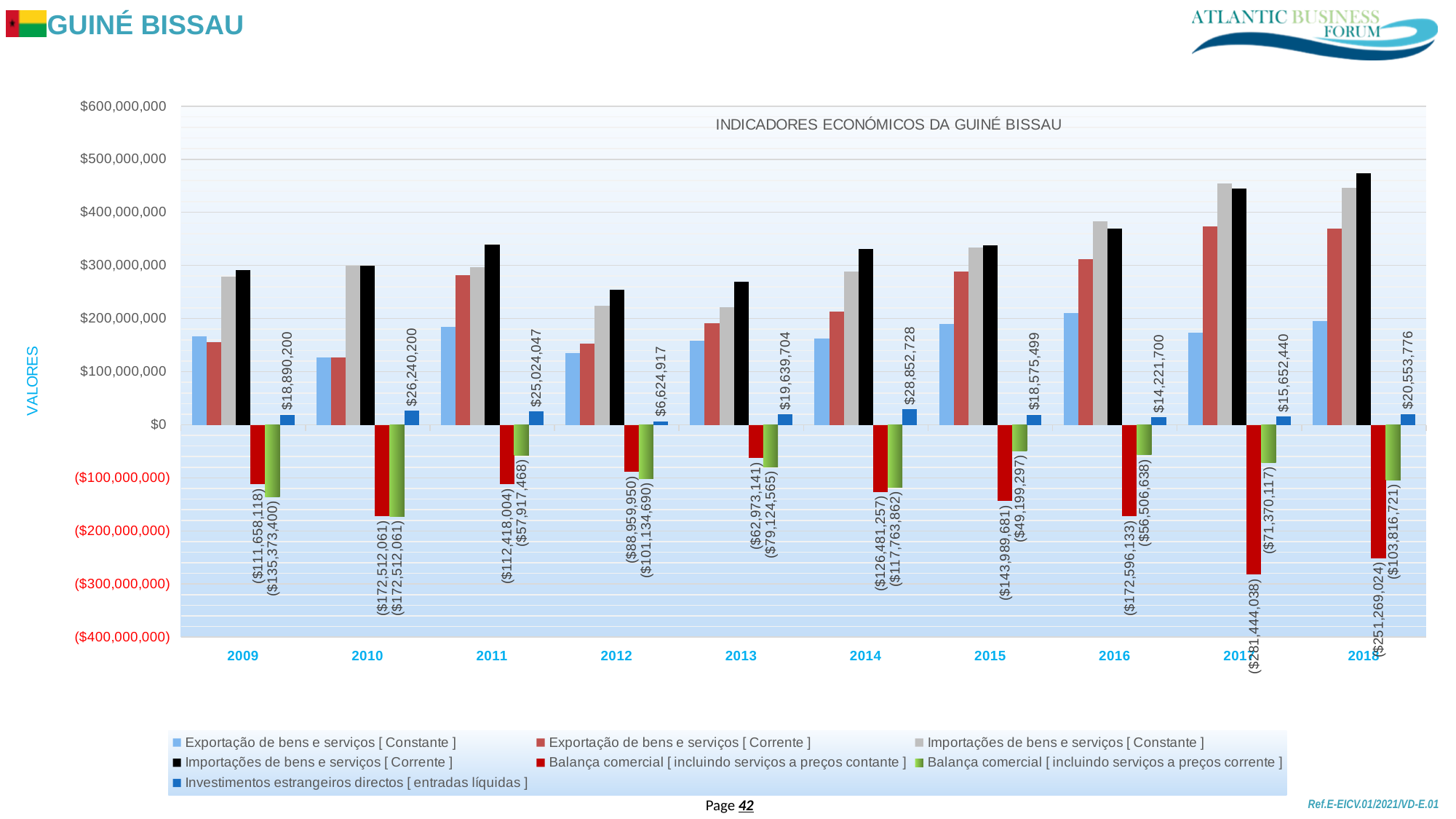
By how much did Investimentos estrangeiros directos [entradas líquidas] increase from 2009 to 2010? $7,350,000 Is the value for Exportação de bens e serviços [Constante] in 2009 greater or less than $200,000,000? less Which year has the larger value of Investimentos estrangeiros directos [entradas líquidas], 2013 or 2015? 2013 Is the value for Importações de bens e serviços [Corrente] in 2018 greater or less than $400,000,000? greater In which year is Investimentos estrangeiros directos [entradas líquidas] lowest? 2012 What is the value of Balança comercial [incluindo serviços a preços contante] in 2017? ($281,444,038) What is the value of Balança comercial [incluindo serviços a preços corrente] in 2018? ($103,816,721) In which year is Investimentos estrangeiros directos [entradas líquidas] highest? 2014 How many years are shown on the x axis of the chart? 10 What is the title of the chart? INDICADORES ECONÓMICOS DA GUINÉ BISSAU What is the value of Investimentos estrangeiros directos [entradas líquidas] in 2014? $28,852,728 How many series does the chart legend list? 7